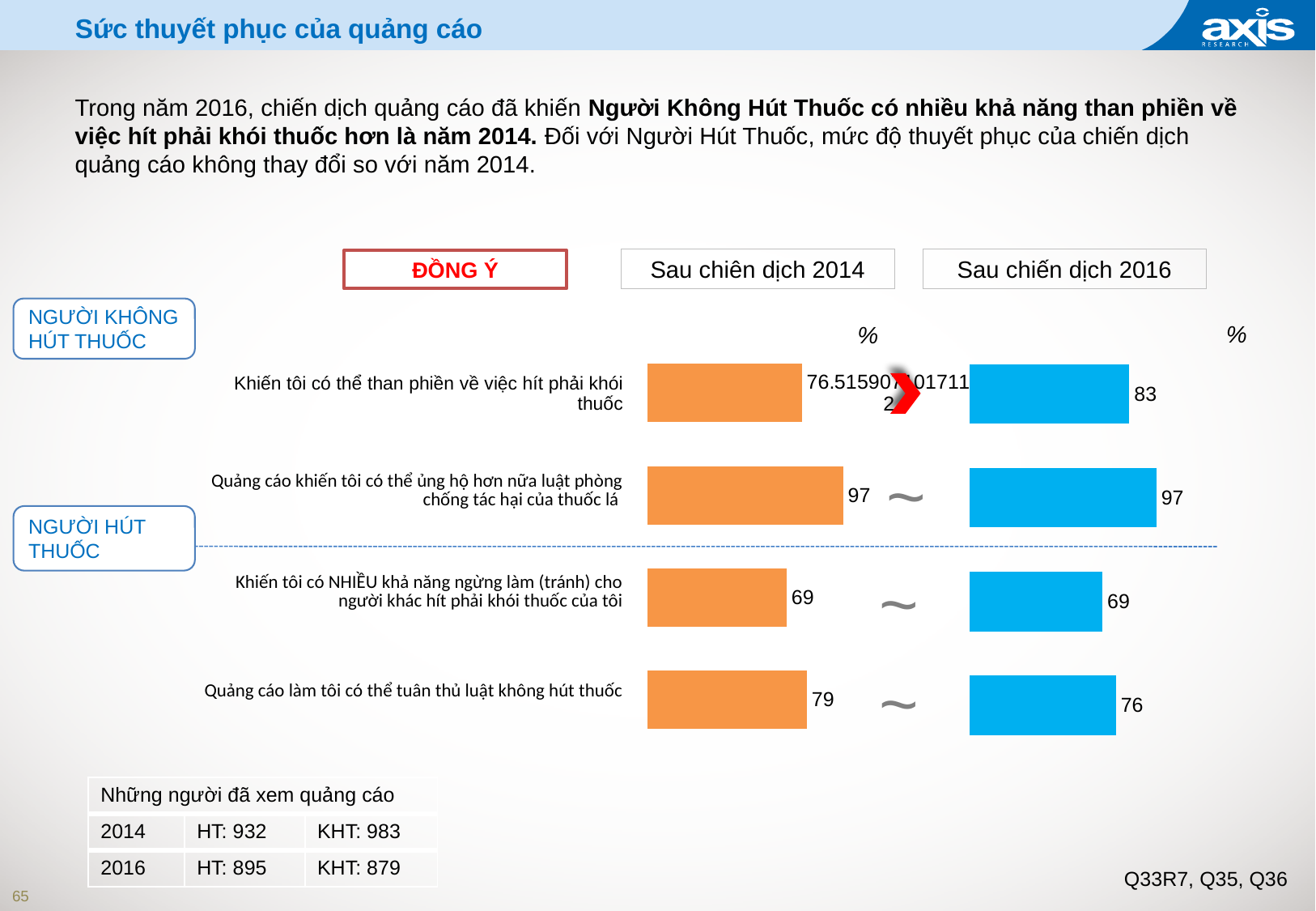
What kind of chart is used to show the 'Sau chiến dịch 2016' values? Bar chart For 'Quảng cáo làm tôi có thể tuân thủ luật không hút thuốc', which is larger: the 2014 value or the 2016 value? 2014 For 'Quảng cáo làm tôi có thể tuân thủ luật không hút thuốc', what is the difference between the 2014 value and the 2016 value? 3 How many categories are shown in the 'Sau chiến dịch 2016' chart? 4 In the 'Sau chiến dịch 2016' chart, which category has the lowest value? Khiến tôi có NHIỀU khả năng ngừng làm (tránh) cho người khác hít phải khói thuốc của tôi In the 'Sau chiến dịch 2016' chart, which category has the highest value? Quảng cáo khiến tôi có thể ủng hộ hơn nữa luật phòng chống tác hại của thuốc lá In the 'Sau chiên dịch 2014' chart, which category has the lowest value? Khiến tôi có NHIỀU khả năng ngừng làm (tránh) cho người khác hít phải khói thuốc của tôi In the 'Sau chiên dịch 2014' chart, what is the value for 'Quảng cáo làm tôi có thể tuân thủ luật không hút thuốc'? 79 In the 'Sau chiên dịch 2014' chart, what is the value for 'Khiến tôi có NHIỀU khả năng ngừng làm (tránh) cho người khác hít phải khói thuốc của tôi'? 69 In the 'Sau chiến dịch 2016' chart, what is the value for 'Khiến tôi có thể than phiền về việc hít phải khói thuốc'? 83 In the 'Sau chiến dịch 2016' chart, what is the value for 'Quảng cáo làm tôi có thể tuân thủ luật không hút thuốc'? 76 In the 'Sau chiên dịch 2014' chart, what is the value for 'Quảng cáo khiến tôi có thể ủng hộ hơn nữa luật phòng chống tác hại của thuốc lá'? 97